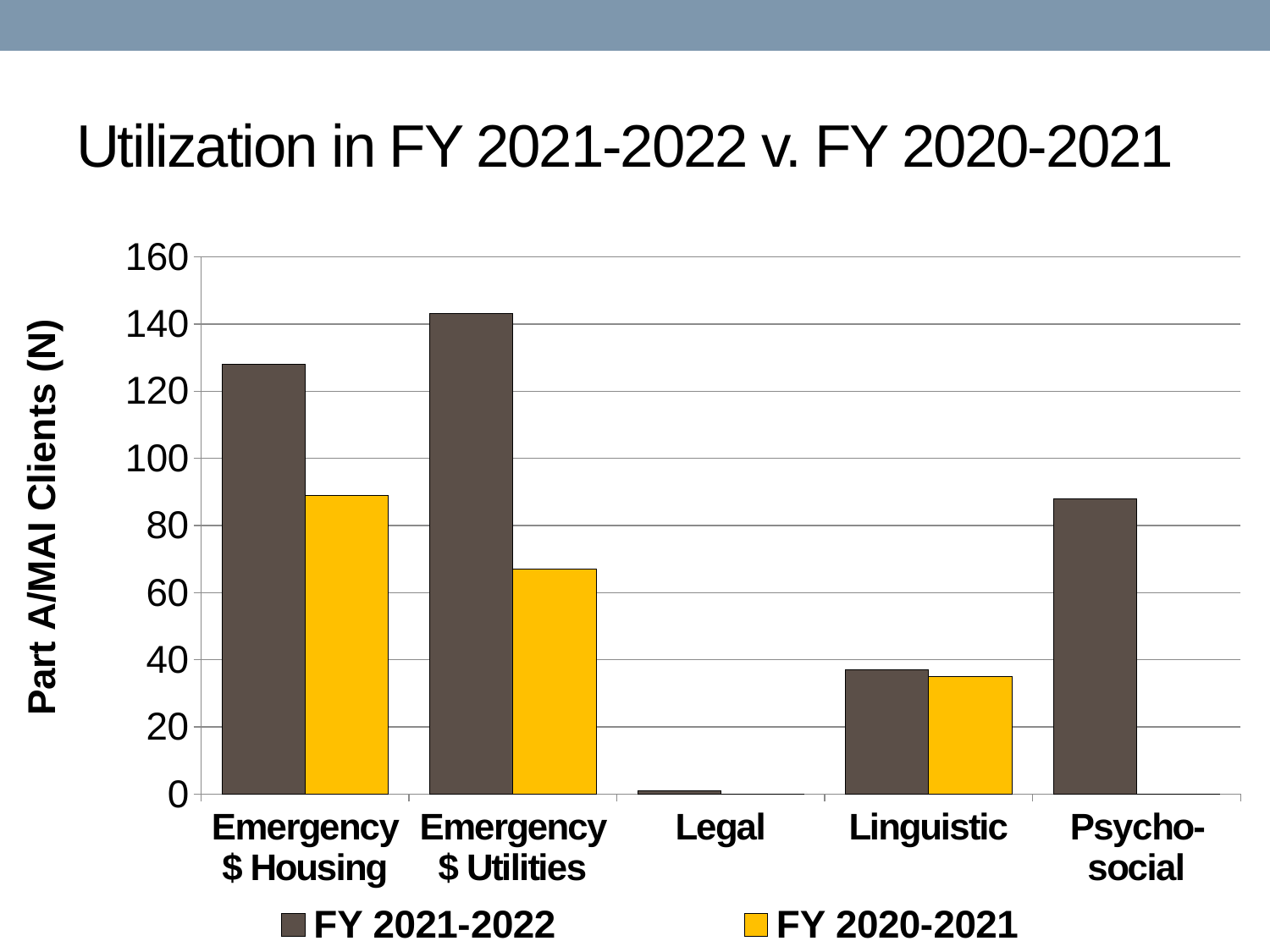
Is the FY 2020-2021 value for Emergency $ Utilities greater or less than 80? less How many series does the legend list? 2 Is the FY 2021-2022 value for Emergency $ Utilities greater or less than 140? greater Which category has the highest FY 2020-2021 value? Emergency $ Housing Which category has the lowest FY 2021-2022 value? Legal What kind of chart is shown on the slide? bar chart What is the label of the y axis? Part A/MAI Clients (N) How many categories are shown on the x axis? 5 Is the FY 2021-2022 value for Emergency $ Housing greater or less than 120? greater Which category has the highest FY 2021-2022 value? Emergency $ Utilities For Emergency $ Housing, which is larger: the FY 2021-2022 value or the FY 2020-2021 value? FY 2021-2022